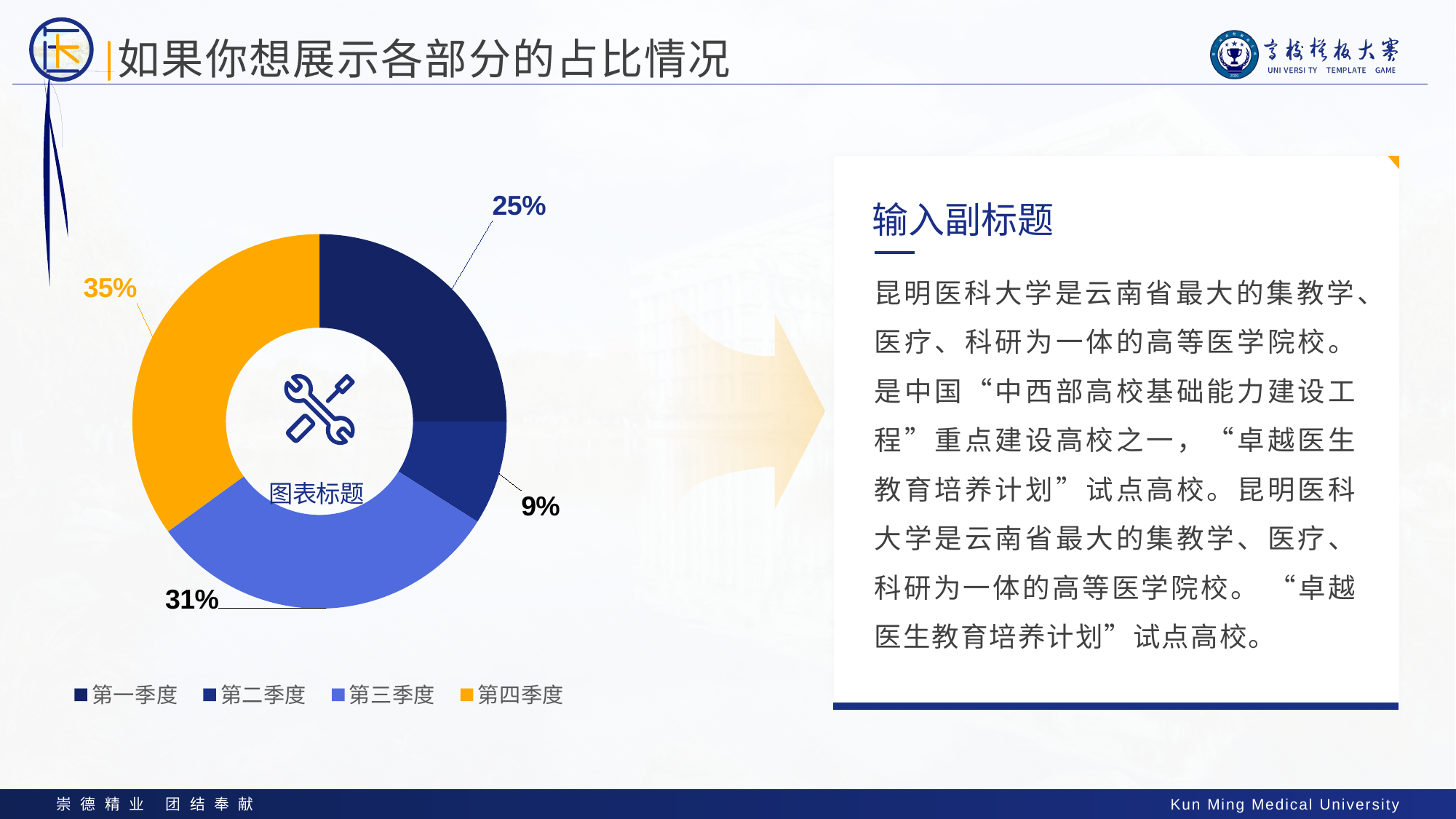
Which quarter has the smallest share in the chart? 第二季度 What share of the doughnut chart does 第四季度 represent? 35% What share of the doughnut chart does 第二季度 represent? 9% How many slices does the doughnut chart have? 4 What type of chart is shown on the slide? Doughnut chart What share of the doughnut chart does 第三季度 represent? 31% What share of the doughnut chart does 第一季度 represent? 25% How many entries does the chart legend list? 4 What is the difference in percentage points between 第四季度 and 第二季度? 26 Which is larger, the share for 第三季度 or the share for 第一季度? 第三季度 Which quarter has the largest share in the chart? 第四季度 What colour is the slice for 第四季度? Orange